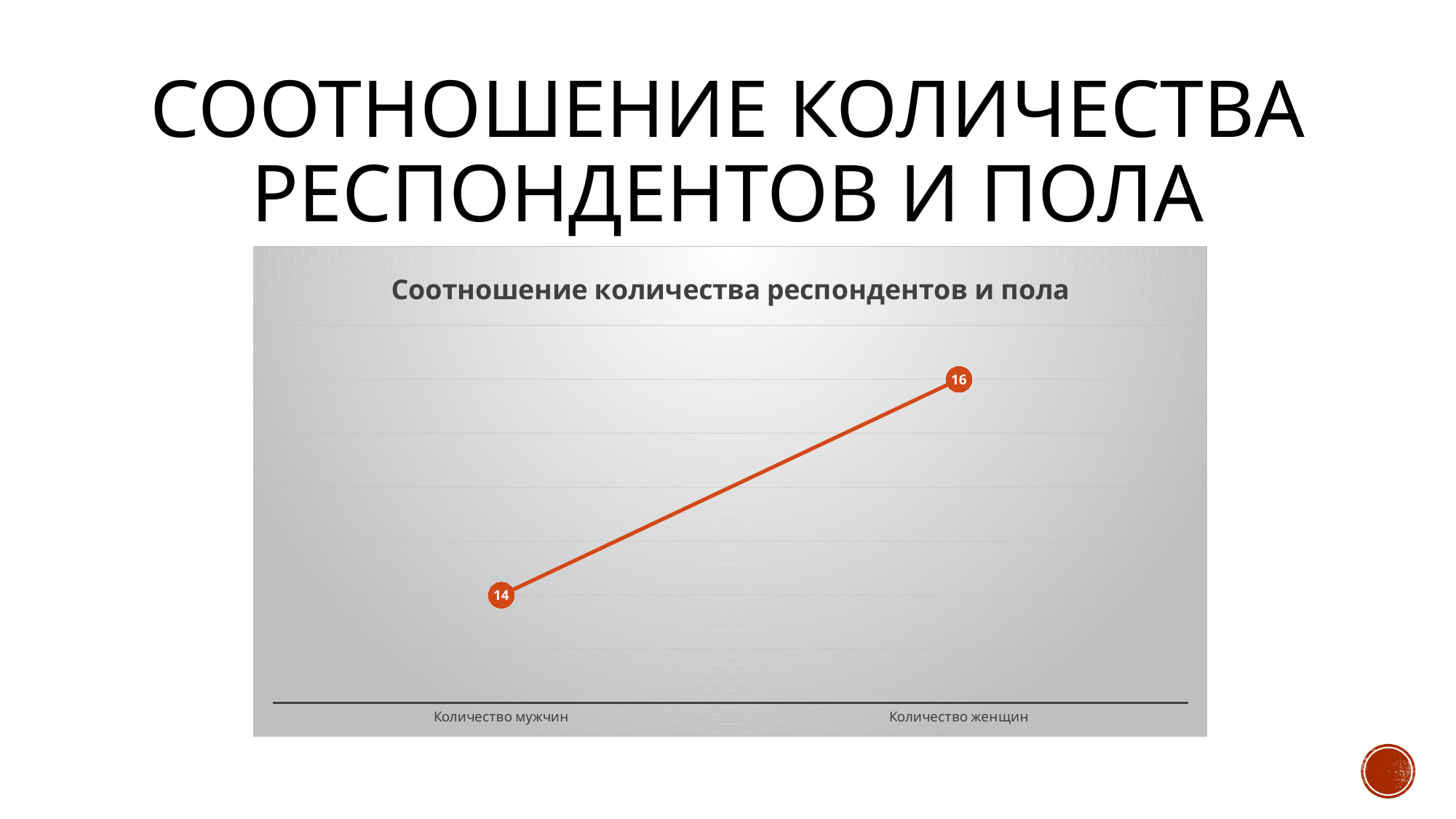
What kind of chart is shown on the slide? line chart What is the value for Количество женщин? 16 Which category has the highest value? Количество женщин What is the difference between the values for Количество женщин and Количество мужчин? 2 Which category has the lowest value? Количество мужчин What is the title of the chart? Соотношение количества респондентов и пола How many categories are plotted on the x axis? 2 Do the values rise or fall from Количество мужчин to Количество женщин? rise What colour is the line in the chart? orange What is the value for Количество мужчин? 14 Which is larger, the value for Количество мужчин or the value for Количество женщин? Количество женщин